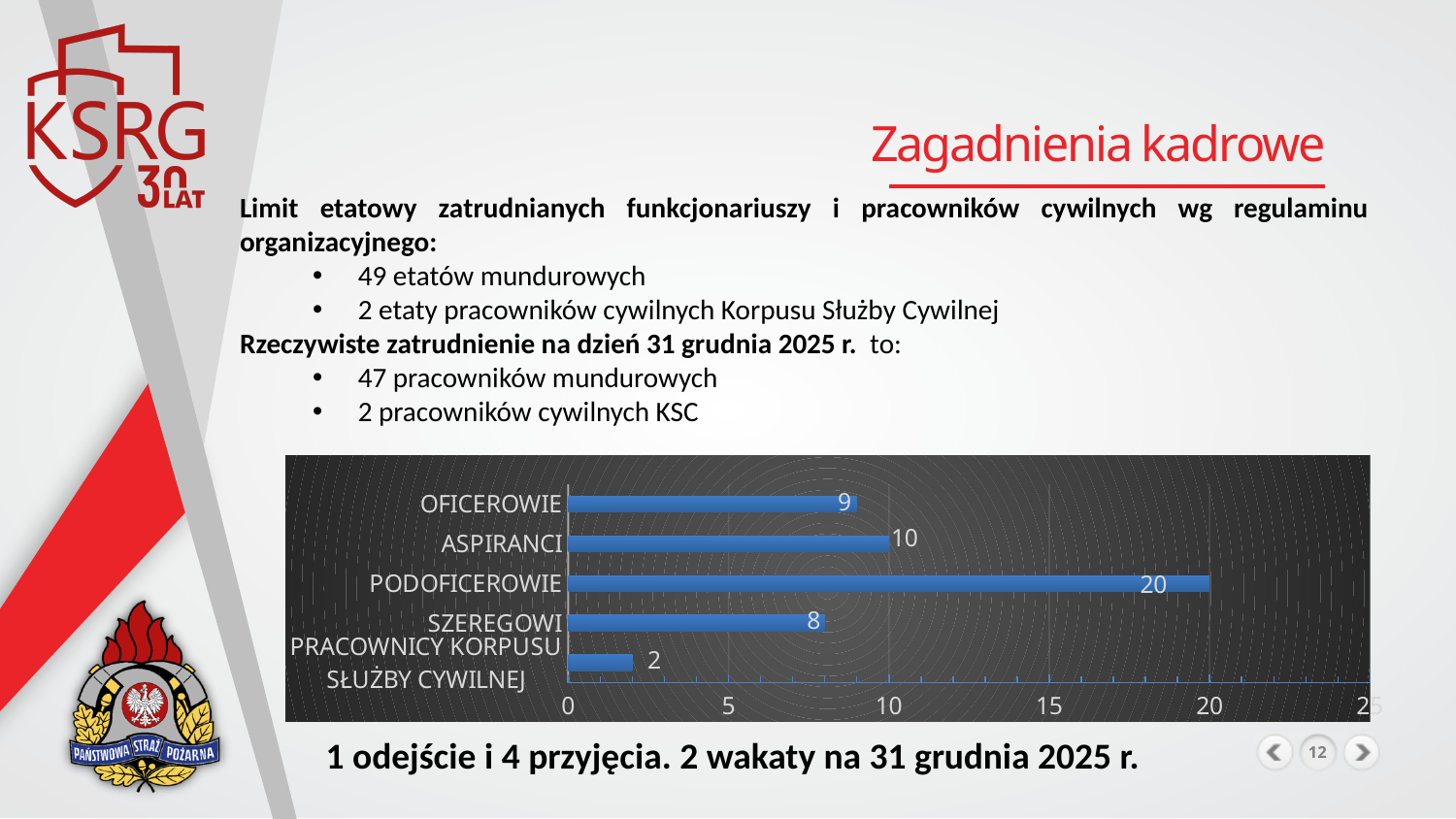
What is the value for PRACOWNICY KORPUSU SŁUŻBY CYWILNEJ? 2 What kind of chart is shown on the slide? bar chart What is the value for OFICEROWIE? 9 What is the value for SZEREGOWI? 8 Which is larger, the value for OFICEROWIE or the value for SZEREGOWI? OFICEROWIE Which category has the highest value? PODOFICEROWIE Is the value for PODOFICEROWIE greater or less than 15? greater What is the value for PODOFICEROWIE? 20 What is the value for ASPIRANCI? 10 What is the difference between the values for PODOFICEROWIE and ASPIRANCI? 10 Which category has the lowest value? PRACOWNICY KORPUSU SŁUŻBY CYWILNEJ How many categories are shown in the chart? 5